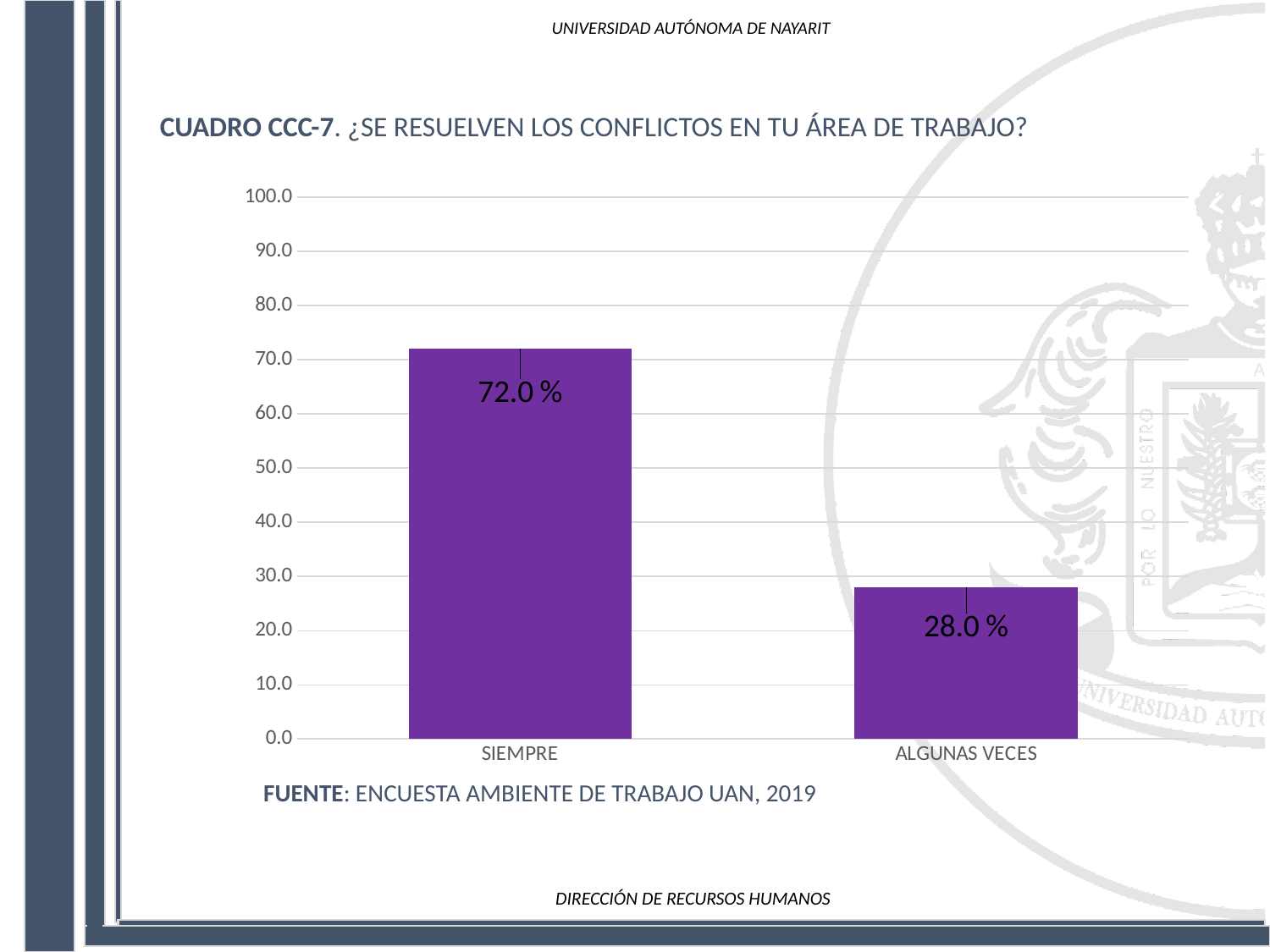
What is the source cited below the chart? ENCUESTA AMBIENTE DE TRABAJO UAN, 2019 Which category has the highest value? SIEMPRE What is the difference between the values for SIEMPRE and ALGUNAS VECES? 44.0 % What is the value for ALGUNAS VECES? 28.0 % How many categories are shown on the x axis? 2 Is the value for ALGUNAS VECES greater or less than 30.0? less What kind of chart is shown on the slide? bar chart What is the value for SIEMPRE? 72.0 % Which category has the lowest value? ALGUNAS VECES What is the title of the chart? CUADRO CCC-7. ¿SE RESUELVEN LOS CONFLICTOS EN TU ÁREA DE TRABAJO? Which is larger, the value for SIEMPRE or the value for ALGUNAS VECES? SIEMPRE Is the value for SIEMPRE greater or less than 50.0? greater